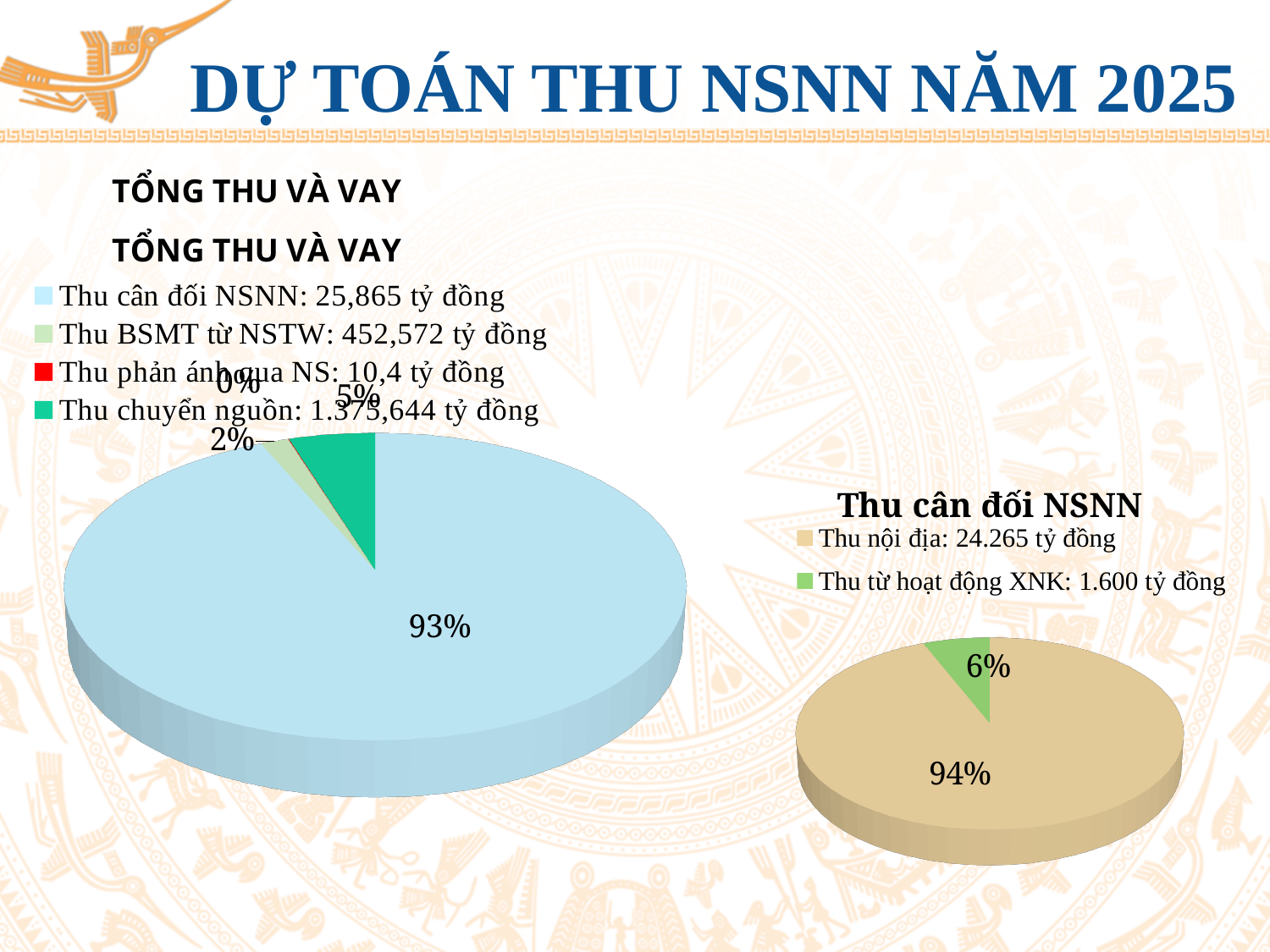
In the "TỔNG THU VÀ VAY" chart, which category has the largest slice? Thu cân đối NSNN In the "TỔNG THU VÀ VAY" chart, what share does Thu chuyển nguồn have? 5% In the "TỔNG THU VÀ VAY" chart, what share does Thu BSMT từ NSTW have? 2% In the "Thu cân đối NSNN" chart on the right, what value does the legend give for Thu từ hoạt động XNK? 1.600 tỷ đồng In the "TỔNG THU VÀ VAY" chart, what value does the legend give for Thu cân đối NSNN? 25,865 tỷ đồng How many categories does the legend of the "TỔNG THU VÀ VAY" chart list? 4 In the "Thu cân đối NSNN" chart on the right, which is larger, Thu nội địa or Thu từ hoạt động XNK? Thu nội địa In the "Thu cân đối NSNN" chart on the right, what share does Thu nội địa have? 94% In the "TỔNG THU VÀ VAY" chart, which category has the smallest slice? Thu phản ánh qua NS What kind of chart is the "TỔNG THU VÀ VAY" chart on the left? pie chart